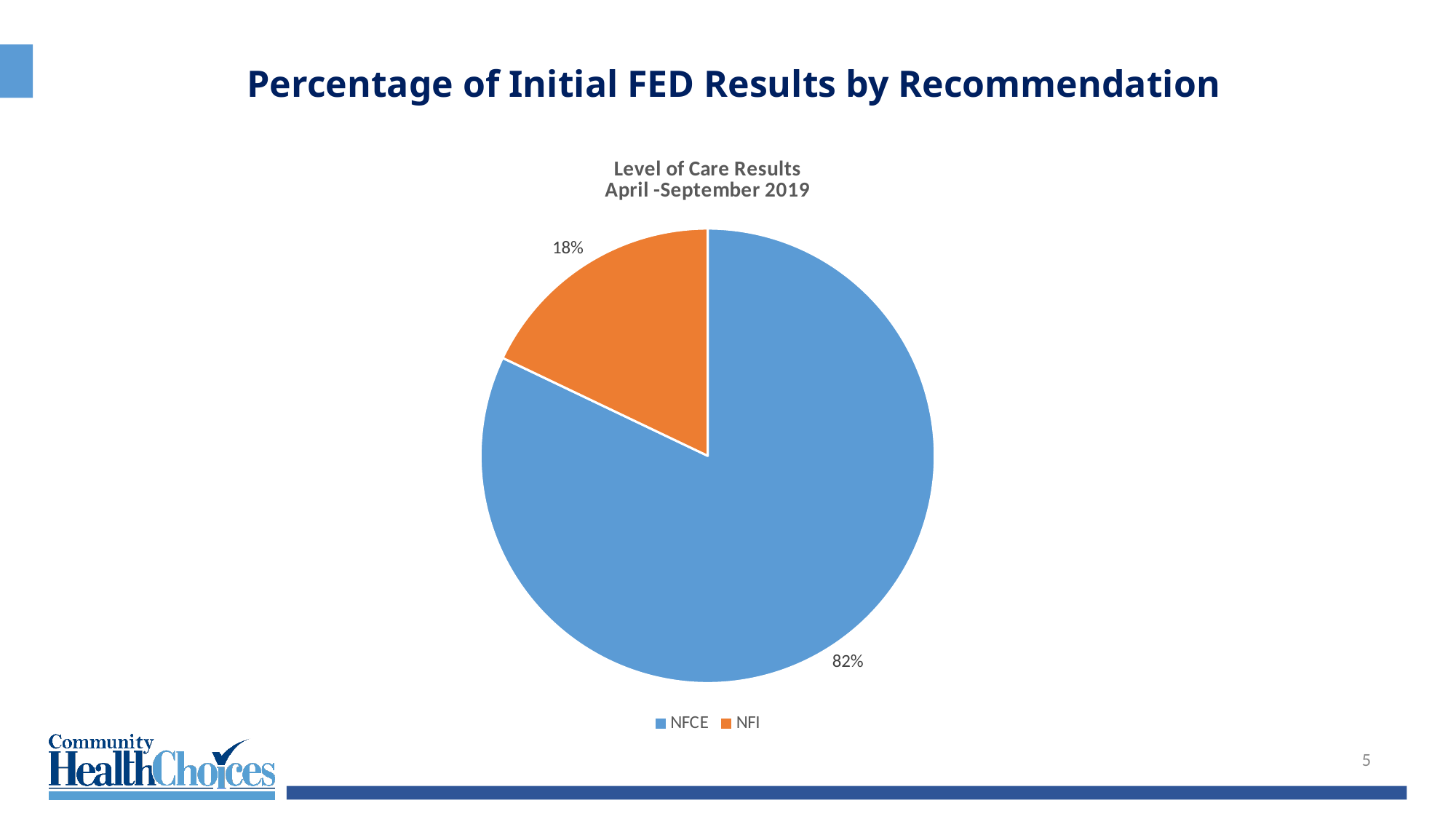
Which category has the largest share of the pie? NFCE What percentage of the pie does NFCE represent? 82% How many slices does the pie chart have? 2 Which category has the smallest share of the pie? NFI What is the title of the chart? Level of Care Results April -September 2019 What percentage of the pie does NFI represent? 18% Which is larger, the NFI share or the NFCE share? NFCE What colour is the NFI slice? orange What is the difference in percentage points between the NFCE and NFI shares? 64 What type of chart is shown on the slide? pie chart How many entries does the legend list? 2 What is the share of the pie taken by the blue slice? 82%